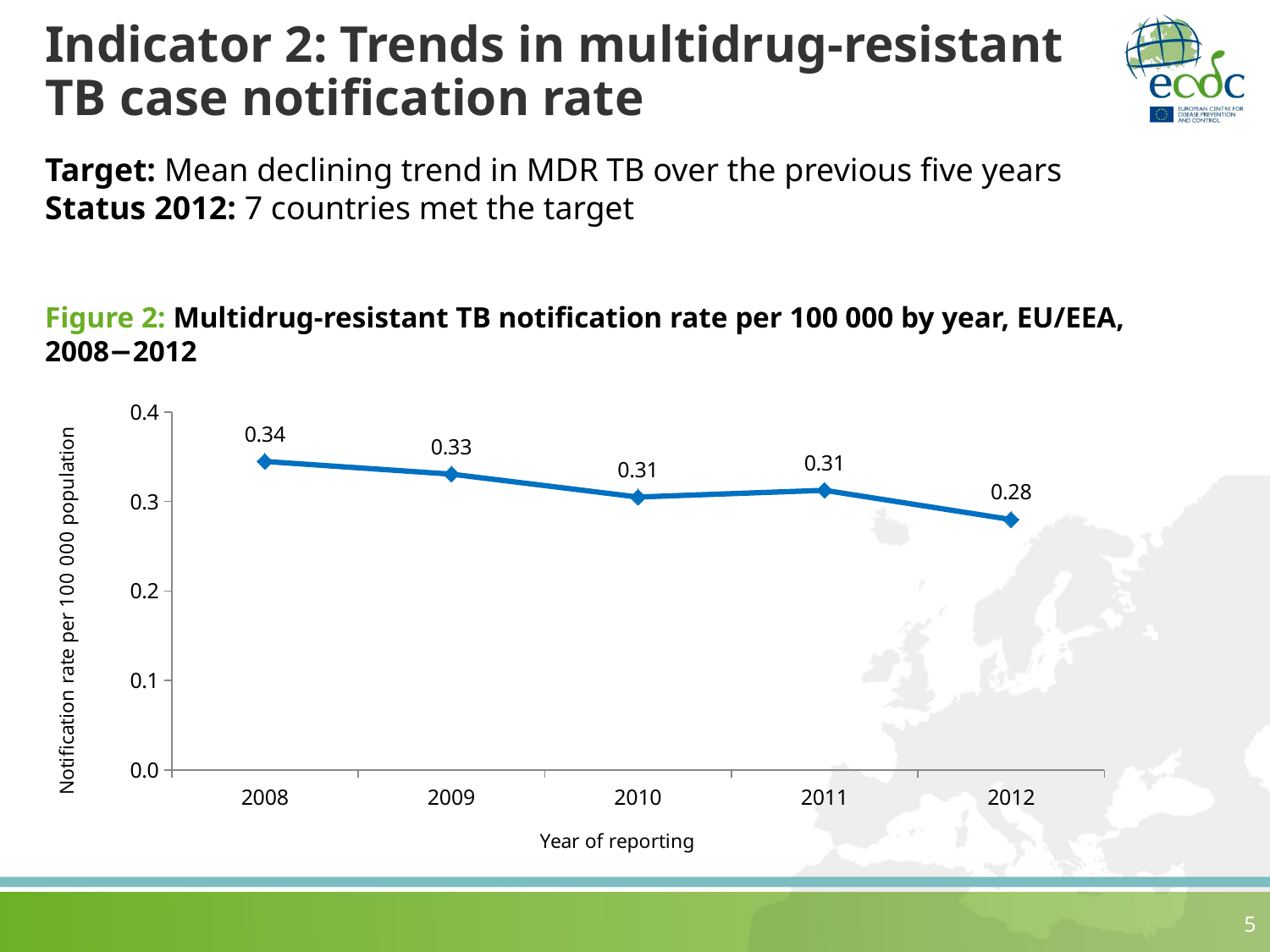
What kind of chart is shown in Figure 2? line chart What is the label of the x axis of the chart? Year of reporting How many years are plotted on the chart? 5 Which year has a higher notification rate, 2009 or 2012? 2009 What is the multidrug-resistant TB notification rate per 100 000 for 2012? 0.28 Which year has the lowest multidrug-resistant TB notification rate? 2012 Is the notification rate for 2011 greater or less than 0.2? greater What is the multidrug-resistant TB notification rate per 100 000 for 2008? 0.34 What is the multidrug-resistant TB notification rate per 100 000 for 2010? 0.31 Do the notification rates generally rise or fall from 2008 to 2012? fall What is the difference between the notification rate in 2008 and in 2012? 0.06 Which year has the highest multidrug-resistant TB notification rate? 2008